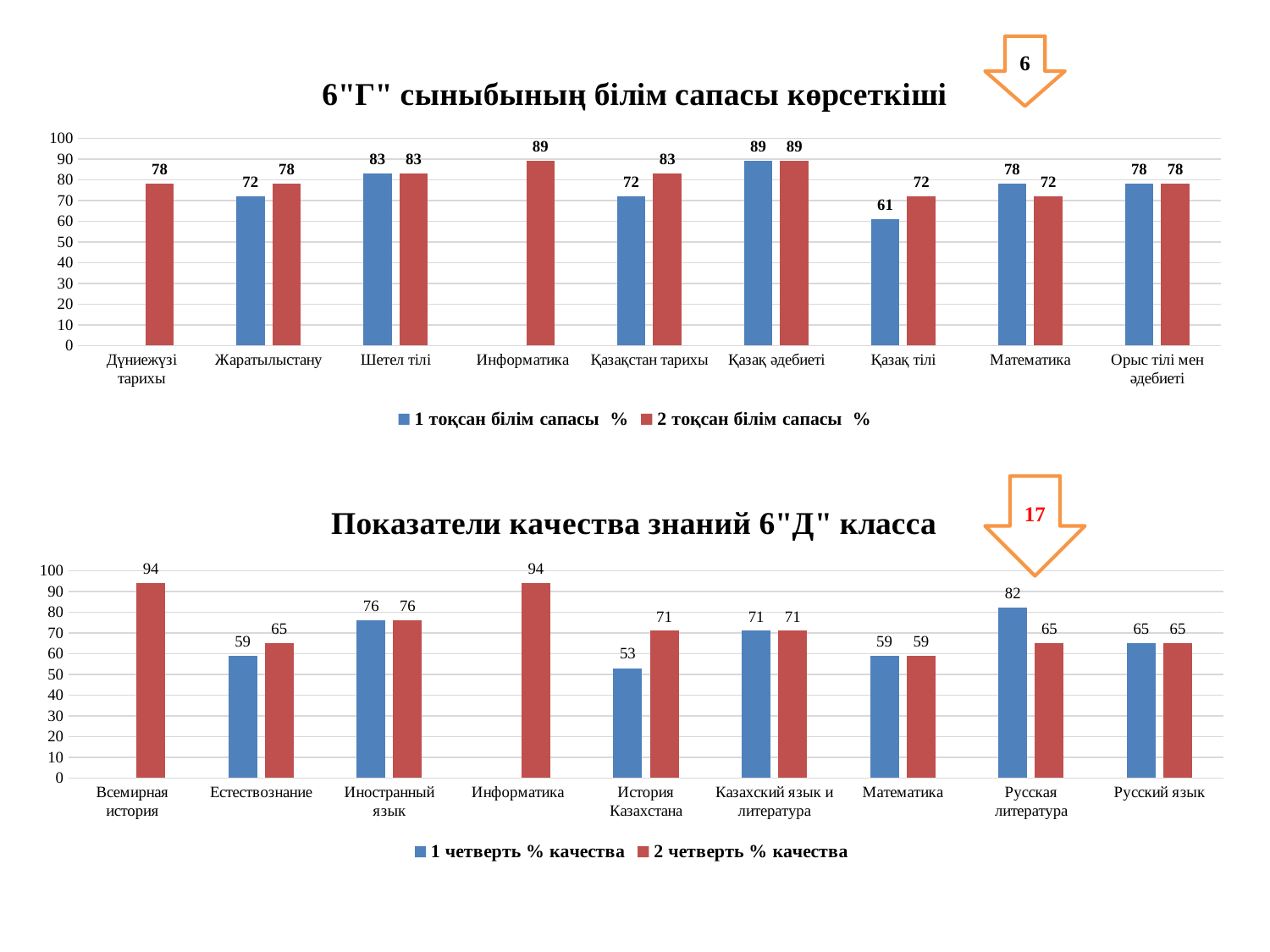
In the top chart (6"Г" сыныбының білім сапасы көрсеткіші), how many categories are shown on the x axis? 9 In the top chart (6"Г" сыныбының білім сапасы көрсеткіші), what is the value of 1 тоқсан білім сапасы % for Қазақ тілі? 61 In the top chart (6"Г" сыныбының білім сапасы көрсеткіші), which category has the lowest 1 тоқсан білім сапасы % value? Қазақ тілі In the top chart (6"Г" сыныбының білім сапасы көрсеткіші), what is the difference between the 2 тоқсан and 1 тоқсан values for Қазақстан тарихы? 11 In the bottom chart (Показатели качества знаний 6"Д" класса), what is the difference between the 1 четверть and 2 четверть values for Русская литература? 17 In the top chart (6"Г" сыныбының білім сапасы көрсеткіші), which is larger for Математика: 1 тоқсан білім сапасы % or 2 тоқсан білім сапасы %? 1 тоқсан білім сапасы % In the top chart (6"Г" сыныбының білім сапасы көрсеткіші), what is the value of 2 тоқсан білім сапасы % for Информатика? 89 In the bottom chart (Показатели качества знаний 6"Д" класса), which category has the highest 1 четверть % качества value? Русская литература In the bottom chart (Показатели качества знаний 6"Д" класса), how many series does the legend list? 2 What type of chart is the bottom chart (Показатели качества знаний 6"Д" класса)? Bar chart In the bottom chart (Показатели качества знаний 6"Д" класса), what is the value of 1 четверть % качества for История Казахстана? 53 In the bottom chart (Показатели качества знаний 6"Д" класса), what is the value of 2 четверть % качества for Русская литература? 65